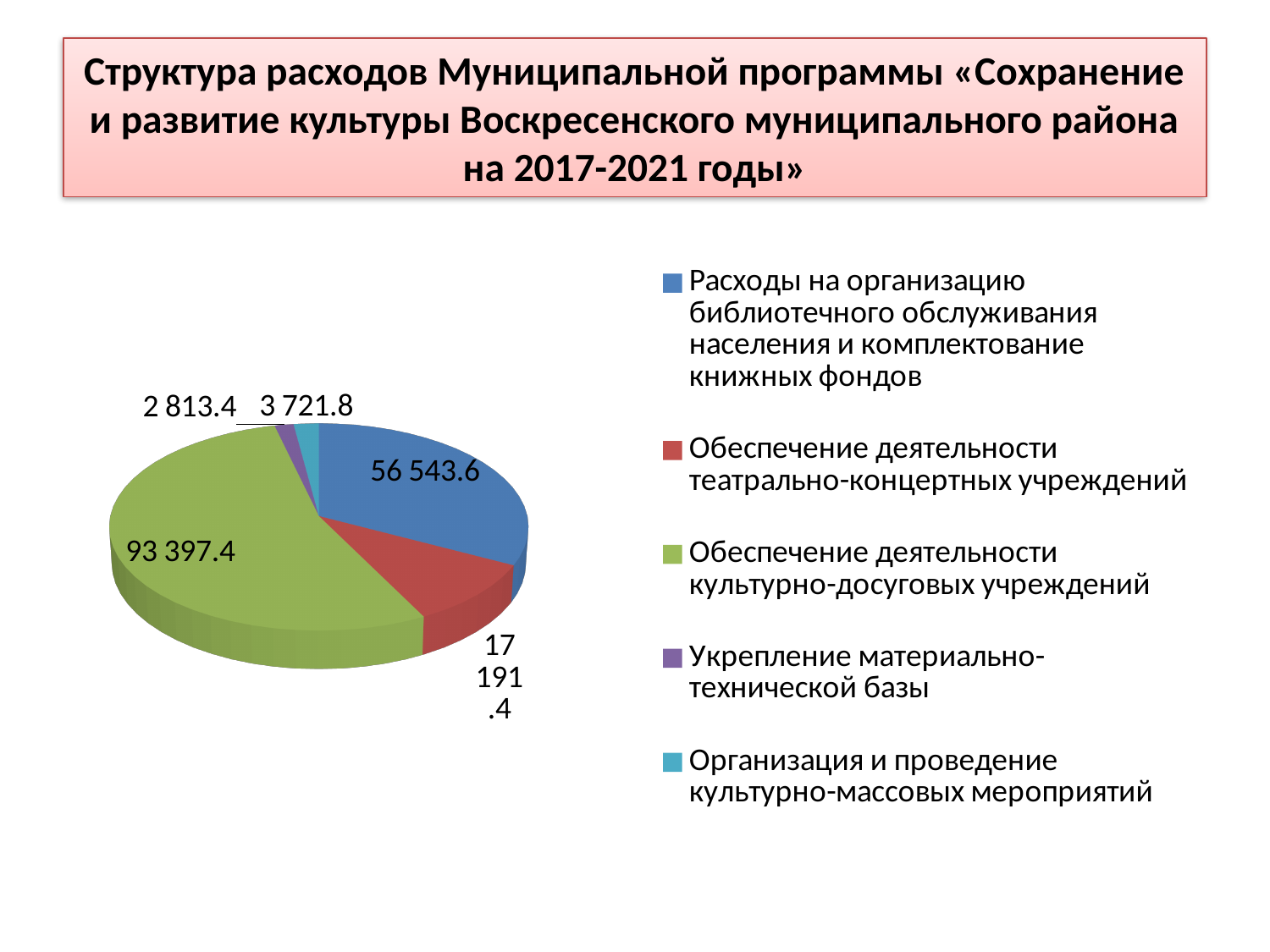
What kind of chart is shown on the slide? Pie chart What is the value for «Обеспечение деятельности театрально-концертных учреждений»? 17 191.4 Which category has the largest slice of the pie? Обеспечение деятельности культурно-досуговых учреждений What is the difference between the values for «Обеспечение деятельности культурно-досуговых учреждений» and «Расходы на организацию библиотечного обслуживания населения и комплектование книжных фондов»? 36 853.8 What is the value for «Расходы на организацию библиотечного обслуживания населения и комплектование книжных фондов»? 56 543.6 How many slices does the pie chart have? 5 Which is larger: the value for «Организация и проведение культурно-массовых мероприятий» or for «Укрепление материально-технической базы»? Организация и проведение культурно-массовых мероприятий Which category has the smallest slice of the pie? Укрепление материально-технической базы What is the value for «Обеспечение деятельности культурно-досуговых учреждений»? 93 397.4 How many entries does the legend list? 5 What is the value for «Организация и проведение культурно-массовых мероприятий»? 3 721.8 What is the value for «Укрепление материально-технической базы»? 2 813.4